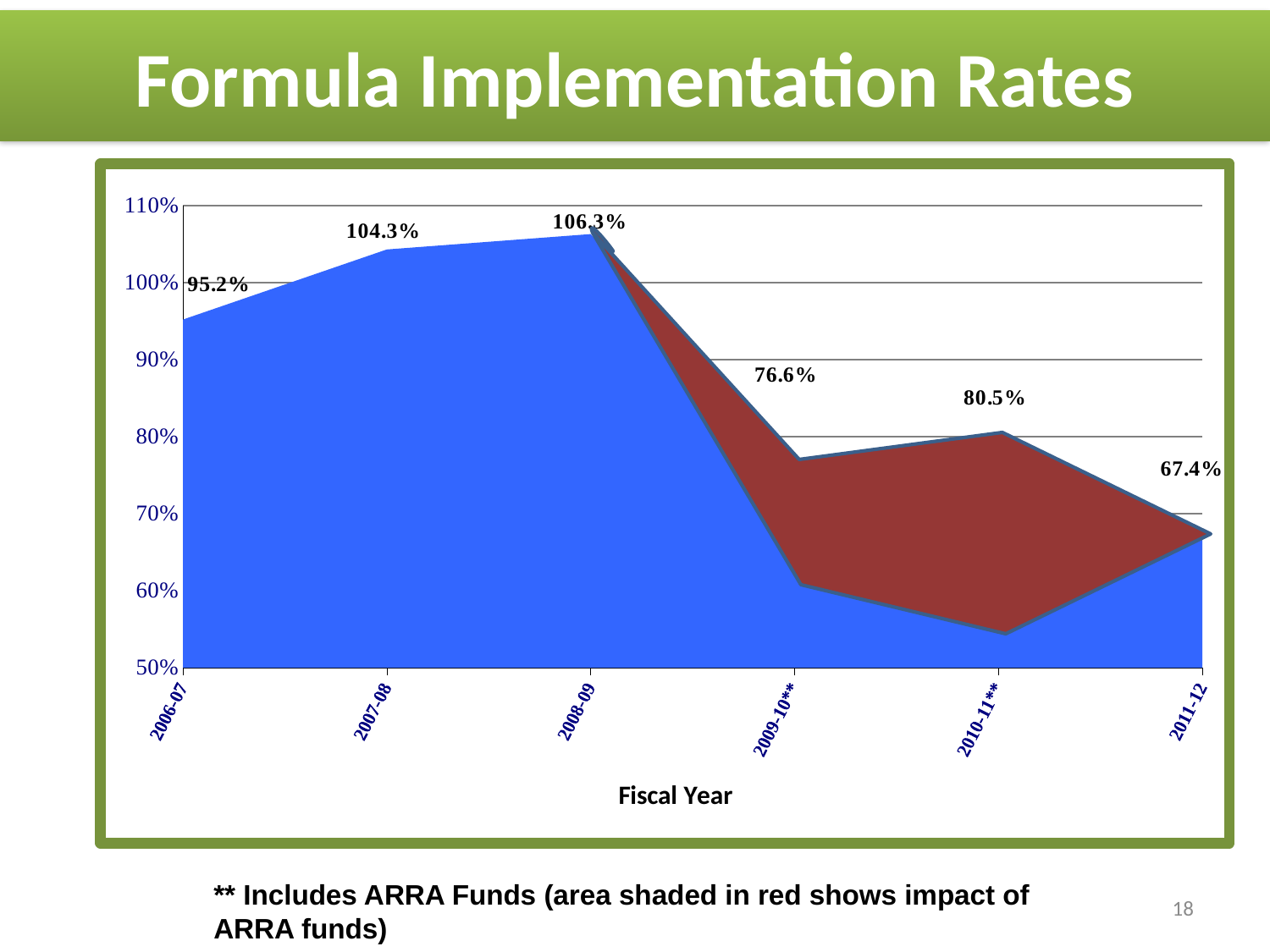
What value is labeled for fiscal year 2011-12? 67.4% Which fiscal year has the lowest labeled value? 2011-12 What value is labeled for fiscal year 2008-09? 106.3% What is the title of the x axis? Fiscal Year Which fiscal year has the highest labeled value? 2008-09 How many fiscal years are plotted on the x axis? 6 What is the formula implementation rate shown for 2006-07? 95.2% Is the labeled value for 2007-08 greater or less than 100%? greater What kind of chart is shown on the slide? Area chart Which is larger, the labeled value for 2009-10** or for 2010-11**? 2010-11** What is the difference between the labeled values for 2008-09 and 2007-08? 2% What value is labeled for fiscal year 2010-11**? 80.5%